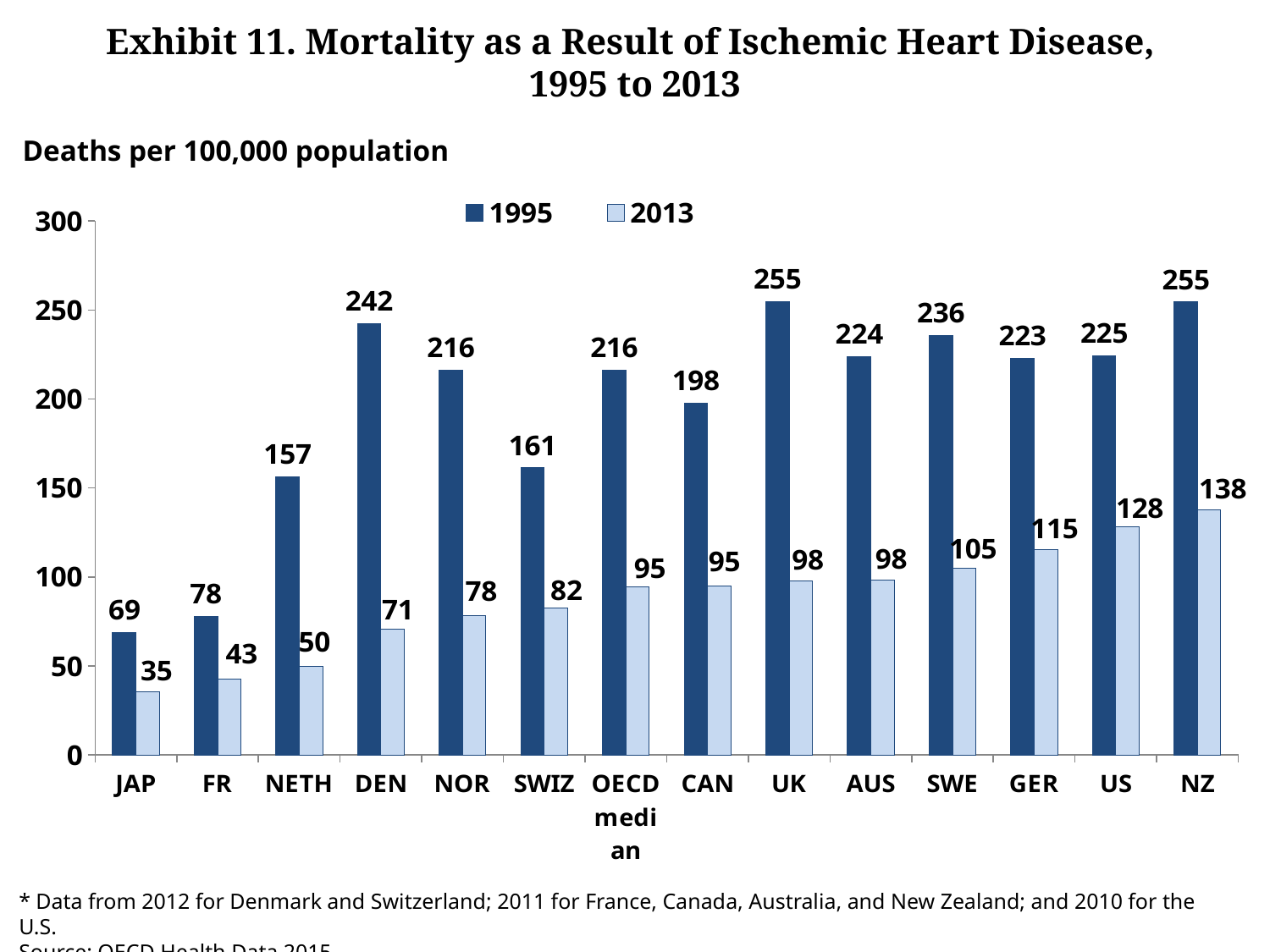
What unit is stated for the values in the chart? Deaths per 100,000 population Which country had the highest 2013 value? NZ Which country had the lowest 1995 value? JAP How many categories are shown on the x axis? 14 What is the difference between the 1995 and 2013 values for the UK? 157 What was the 2013 value for the OECD median? 95 What kind of chart is shown on the slide? Bar chart How many series does the legend list? 2 What was the 2013 value for the United States (US)? 128 Which is larger, the 1995 value for Sweden (SWE) or the 1995 value for Germany (GER)? SWE What was the 1995 value for Denmark (DEN)? 242 Which country had the lowest 2013 value? JAP